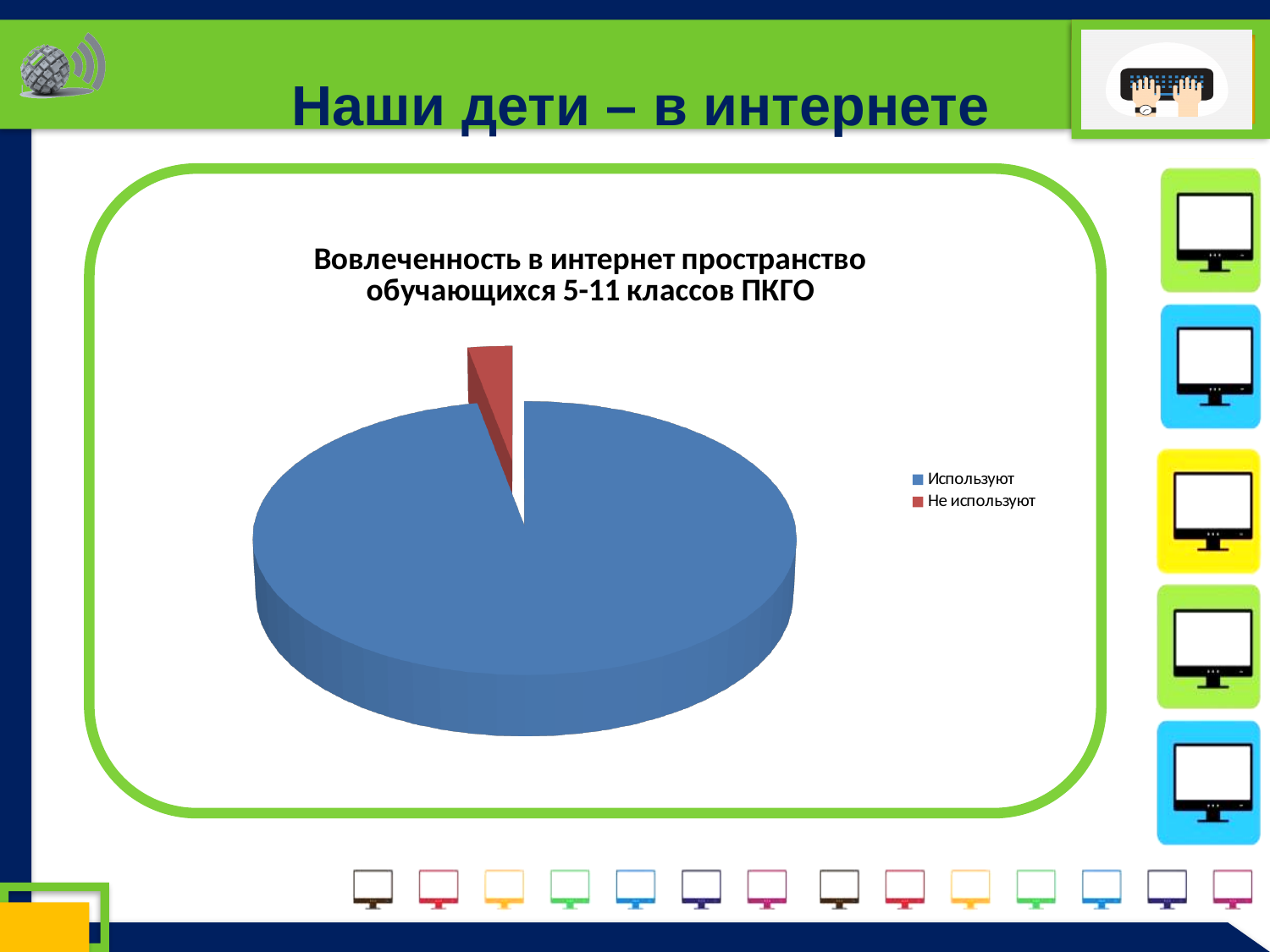
What colour is the "Не используют" slice in the pie chart? Red Which category has the smallest slice in the pie chart? Не используют What is the title of the pie chart? Вовлеченность в интернет пространство обучающихся 5-11 классов ПКГО Which category has the largest slice in the pie chart? Используют How many entries does the legend of the pie chart list? 2 Which slice is larger: "Используют" or "Не используют"? Используют How many slices does the pie chart have? 2 What kind of chart is shown on the slide? Pie chart